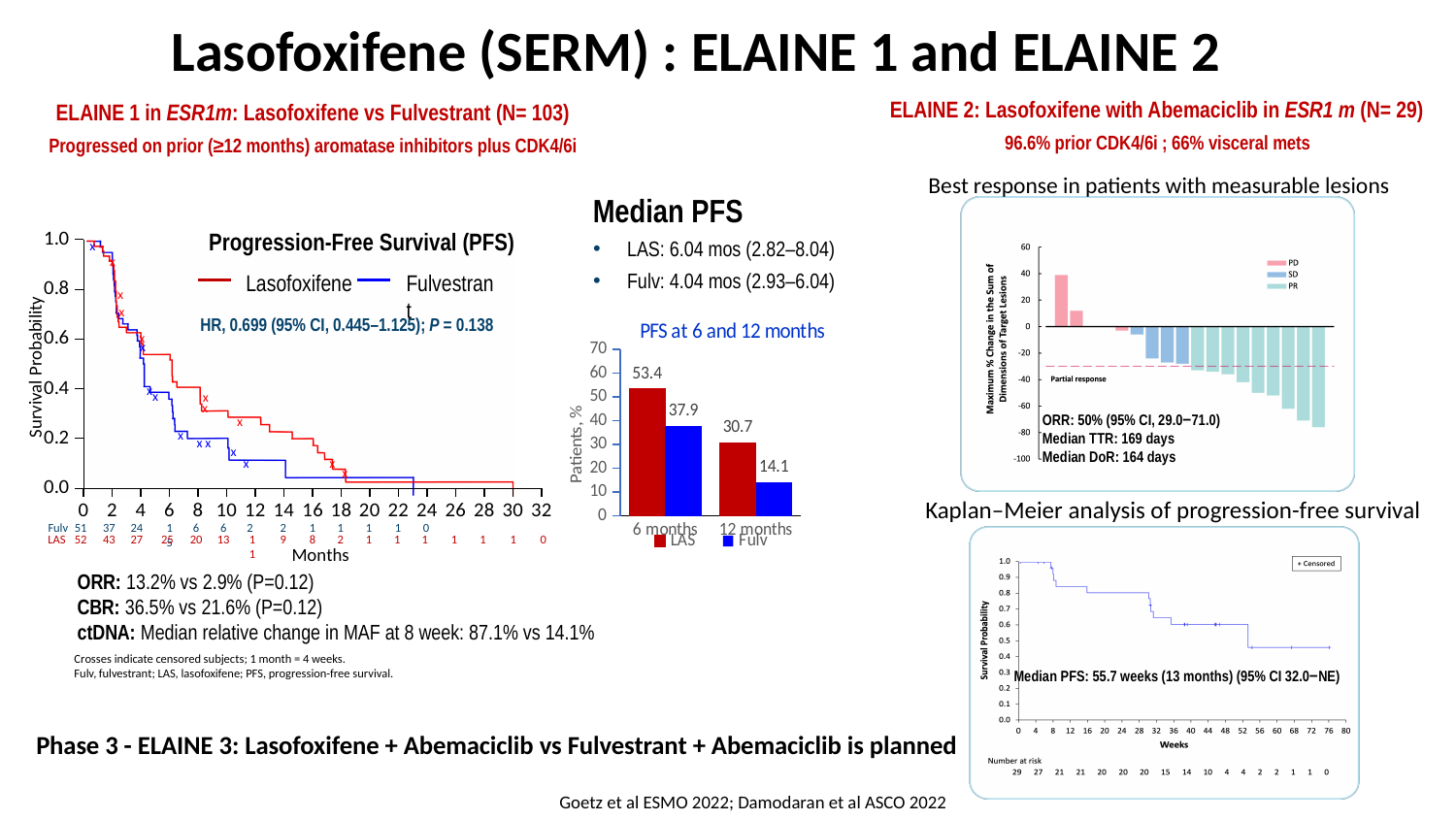
How many series does the legend of the 'PFS at 6 and 12 months' bar chart list? 2 In the 'Progression-Free Survival (PFS)' chart on the left, which colour represents Lasofoxifene? Red In the 'PFS at 6 and 12 months' bar chart, which is larger at 12 months, LAS or Fulv? LAS In the 'PFS at 6 and 12 months' bar chart, what is the value for Fulv at 6 months? 37.9 In the 'PFS at 6 and 12 months' bar chart, what is the value for Fulv at 12 months? 14.1 What kind of chart is the 'PFS at 6 and 12 months' chart? Bar chart In the 'PFS at 6 and 12 months' bar chart, which bar is the lowest? Fulv at 12 months In the 'PFS at 6 and 12 months' bar chart, what is the value for LAS at 6 months? 53.4 In the 'PFS at 6 and 12 months' bar chart, which bar is the highest? LAS at 6 months In the 'PFS at 6 and 12 months' bar chart, what is the value for LAS at 12 months? 30.7 In the 'PFS at 6 and 12 months' bar chart, what is the difference between LAS and Fulv at 6 months? 15.5 In the 'PFS at 6 and 12 months' bar chart, what is the difference between LAS and Fulv at 12 months? 16.6